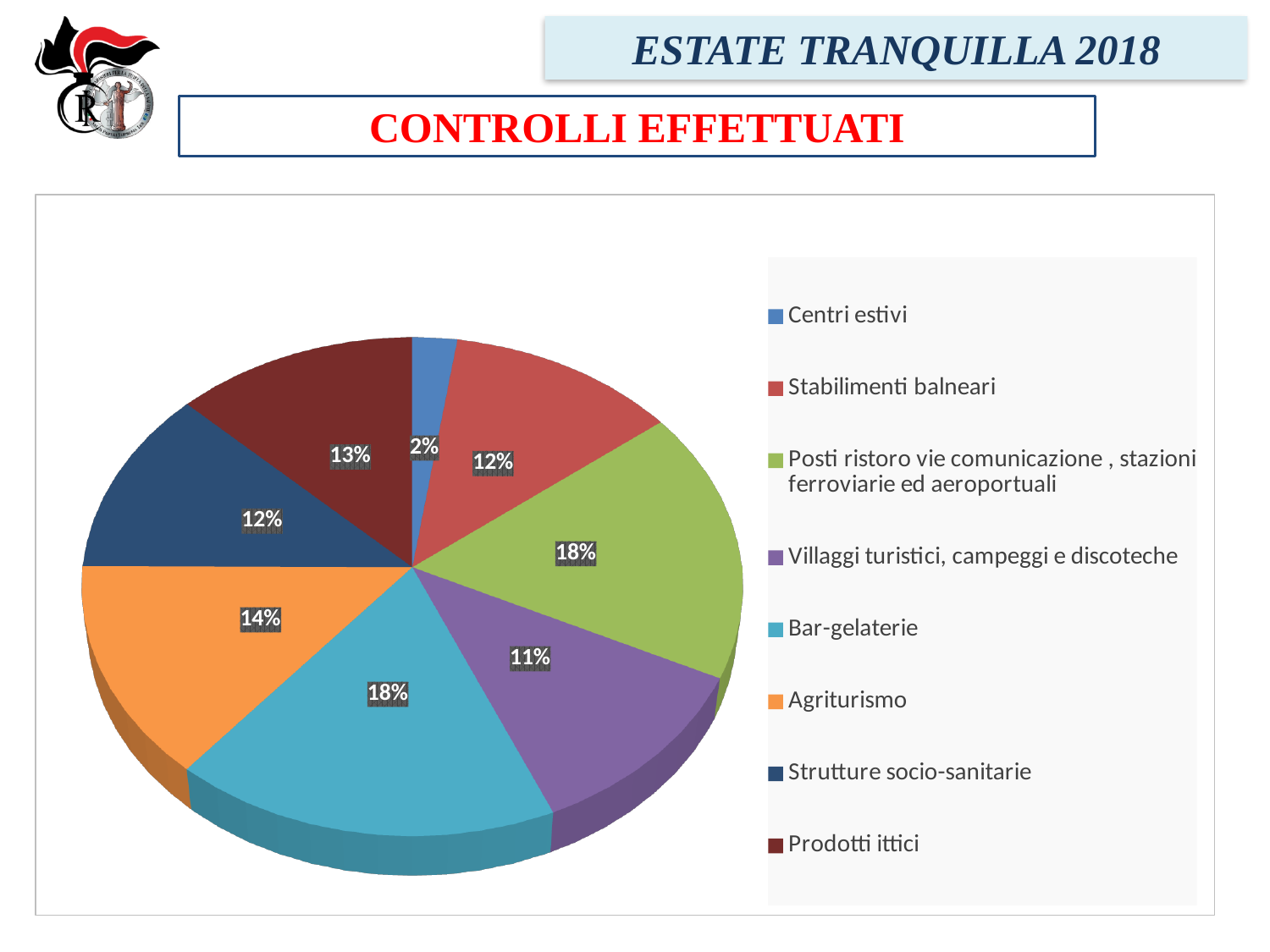
Which category has the smallest slice of the pie? Centri estivi What share of the pie does Bar-gelaterie represent? 18% Which is larger, the share for Agriturismo or the share for Strutture socio-sanitarie? Agriturismo What share of the pie does Prodotti ittici represent? 13% How many categories does the pie chart show? 8 What kind of chart is shown on the slide? pie chart What share of the pie does Centri estivi represent? 2% What is the difference between the share for Prodotti ittici and the share for Centri estivi? 11% What colour is the slice for Agriturismo? orange What is the difference between the share for Bar-gelaterie and the share for Villaggi turistici, campeggi e discoteche? 7%